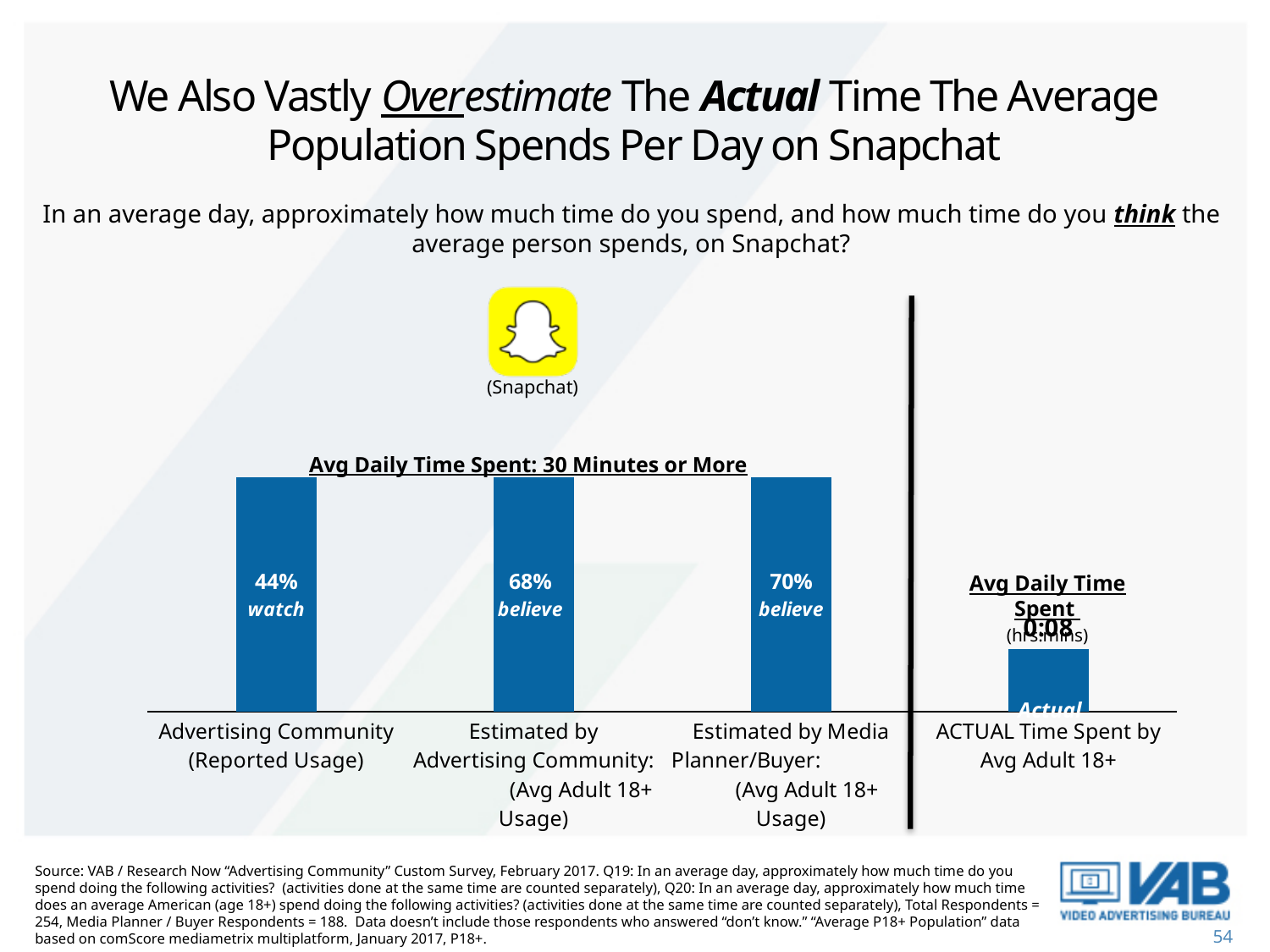
How many bars are in the 'Avg Daily Time Spent: 30 Minutes or More' chart? 3 What percentage of the Advertising Community believes the average adult 18+ spends 30 minutes or more per day on Snapchat? 68% Which is larger: the Advertising Community's reported usage or its estimate of average adult 18+ usage? Estimate of average adult 18+ usage (68%) What is the actual average daily time spent on Snapchat by the average adult 18+, in hrs:mins? 0:08 Which social platform is this slide's chart about? Snapchat What percentage of Media Planners/Buyers believe the average adult 18+ spends 30 minutes or more per day on Snapchat? 70% Which group has the highest percentage in the 'Avg Daily Time Spent: 30 Minutes or More' chart? Estimated by Media Planner/Buyer (Avg Adult 18+ Usage) What is the difference in percentage points between the Media Planner/Buyer estimate (70%) and the Advertising Community reported usage (44%)? 26 percentage points What type of chart is used on this slide? Bar chart What percentage of the Advertising Community reports watching Snapchat for 30 minutes or more per day? 44% What is the difference in percentage points between the Advertising Community's estimate for the average adult and its own reported usage? 24 percentage points